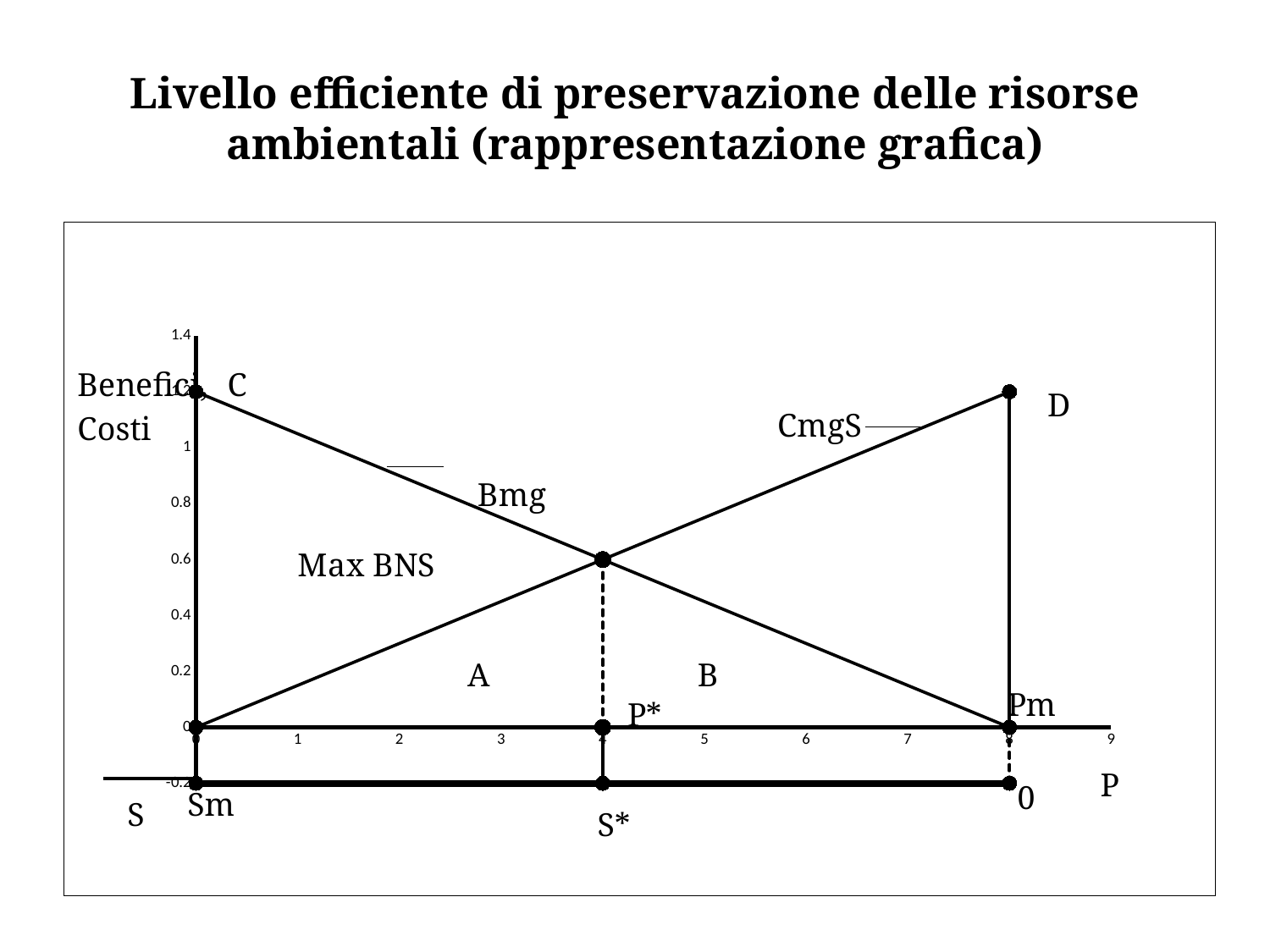
At what value on the x axis do the Bmg and CmgS lines intersect? 4 What is the value of the Bmg line at x = 8 (point Pm)? 0 Is the value of the Bmg line at x = 2 greater or less than 0.8? greater Is the value of the CmgS line at x = 2 greater or less than 0.4? less What is the value of the CmgS line at x = 0? 0 What is the value on the vertical axis where the Bmg and CmgS lines intersect? 0.6 At x = 2, which line has the larger value, Bmg or CmgS? Bmg Does the CmgS line rise or fall as P increases along the x axis? rise Does the Bmg line rise or fall as P increases along the x axis? fall At x = 6, which line has the larger value, Bmg or CmgS? CmgS What kind of chart is shown on the slide? line chart What label is written on the vertical axis of the chart? Benefici Costi